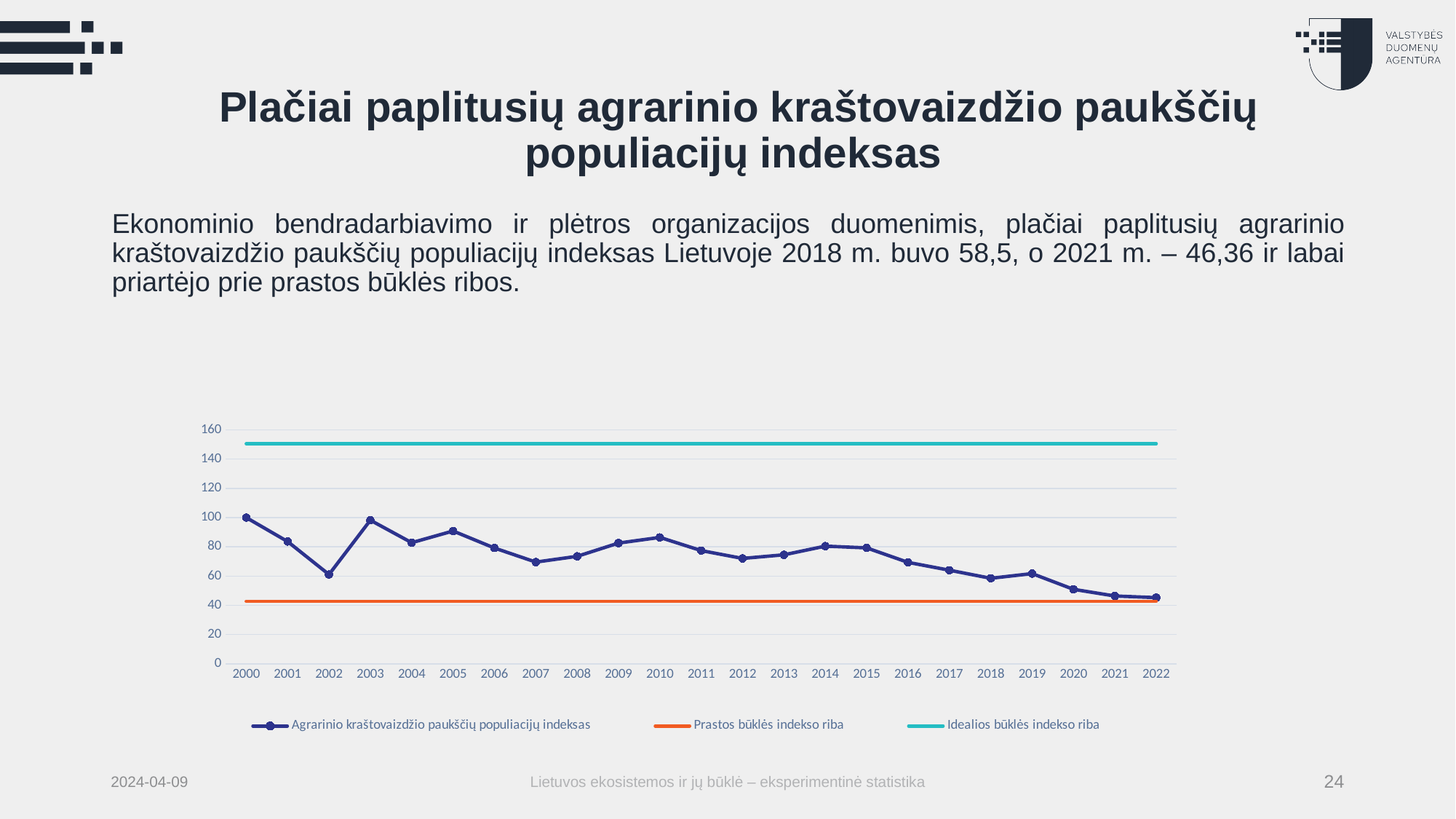
How many years are plotted along the x axis of the chart? 23 Does the Agrarinio kraštovaizdžio paukščių populiacijų indeksas series generally rise or fall from 2000 to 2022? fall In which year is the Agrarinio kraštovaizdžio paukščių populiacijų indeksas series highest? 2000 What is the value of the Agrarinio kraštovaizdžio paukščių populiacijų indeksas series in 2000? 100 Is the value of the Agrarinio kraštovaizdžio paukščių populiacijų indeksas series in 2020 greater or less than 60? less Is the value of the Agrarinio kraštovaizdžio paukščių populiacijų indeksas series in 2002 greater or less than 80? less Which year has the larger value of the Agrarinio kraštovaizdžio paukščių populiacijų indeksas series, 2002 or 2003? 2003 Is the value of the Agrarinio kraštovaizdžio paukščių populiacijų indeksas series in 2003 greater or less than 80? greater Which legend entry is drawn in orange? Prastos būklės indekso riba What kind of chart is shown on the slide? line chart How many series does the chart legend list? 3 Which year has the larger value of the Agrarinio kraštovaizdžio paukščių populiacijų indeksas series, 2005 or 2007? 2005